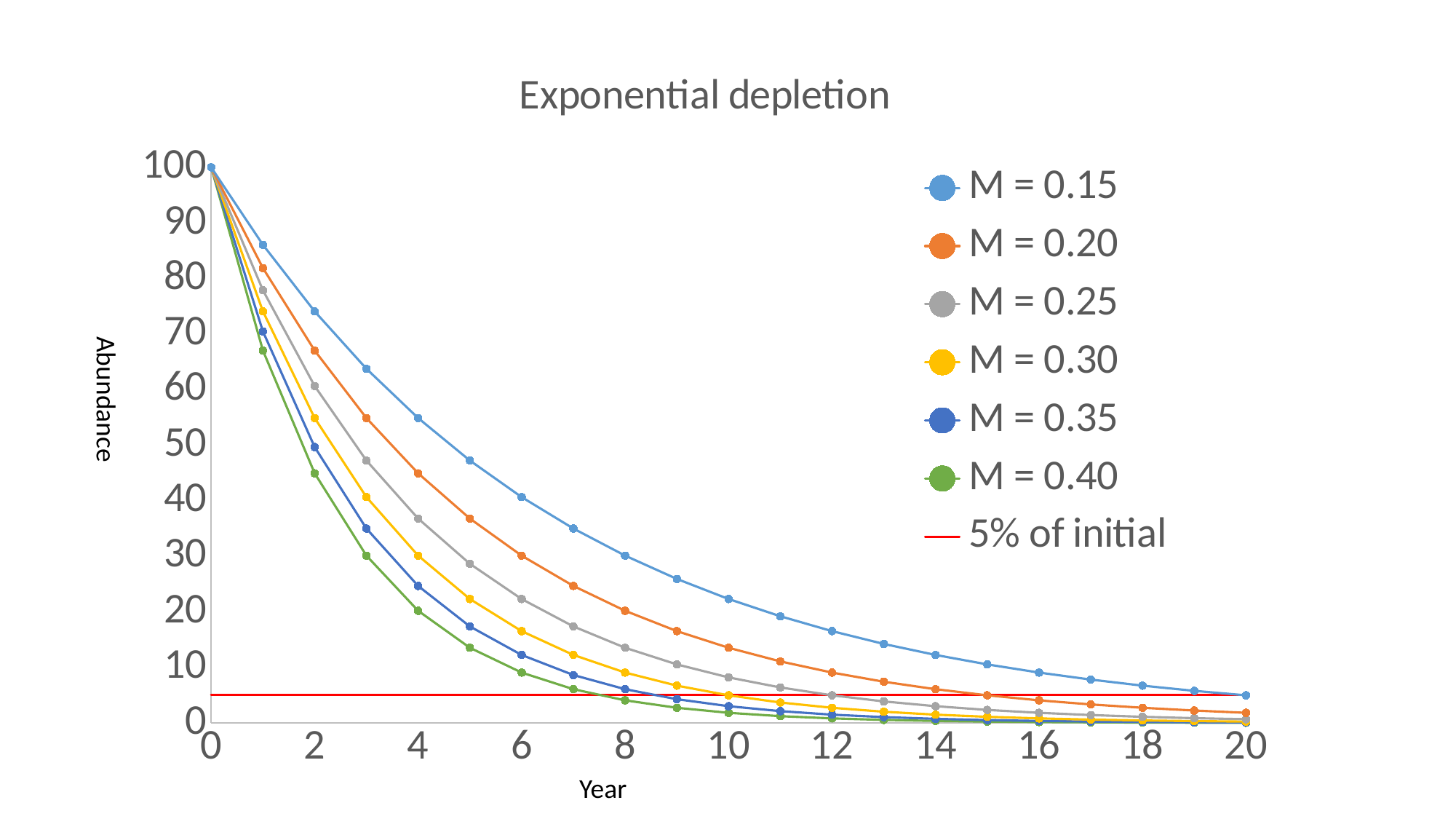
Which series has the lowest abundance at year 4? M = 0.40 Do the abundance values rise or fall as the year increases? fall How many entries does the legend list? 7 At year 5, which series has the larger abundance, M = 0.15 or M = 0.40? M = 0.15 Is the abundance for the M = 0.40 series at year 2 greater or less than 50? less Is the abundance for the M = 0.15 series at year 10 greater or less than 20? greater What is the abundance value for the M = 0.15 series at year 0? 100 What type of chart is shown on the slide? line chart Is the abundance for the M = 0.25 series at year 1 greater or less than 70? greater Which series has the highest abundance at year 10? M = 0.15 What is the title of the chart? Exponential depletion What does the horizontal red line in the chart represent? 5% of initial